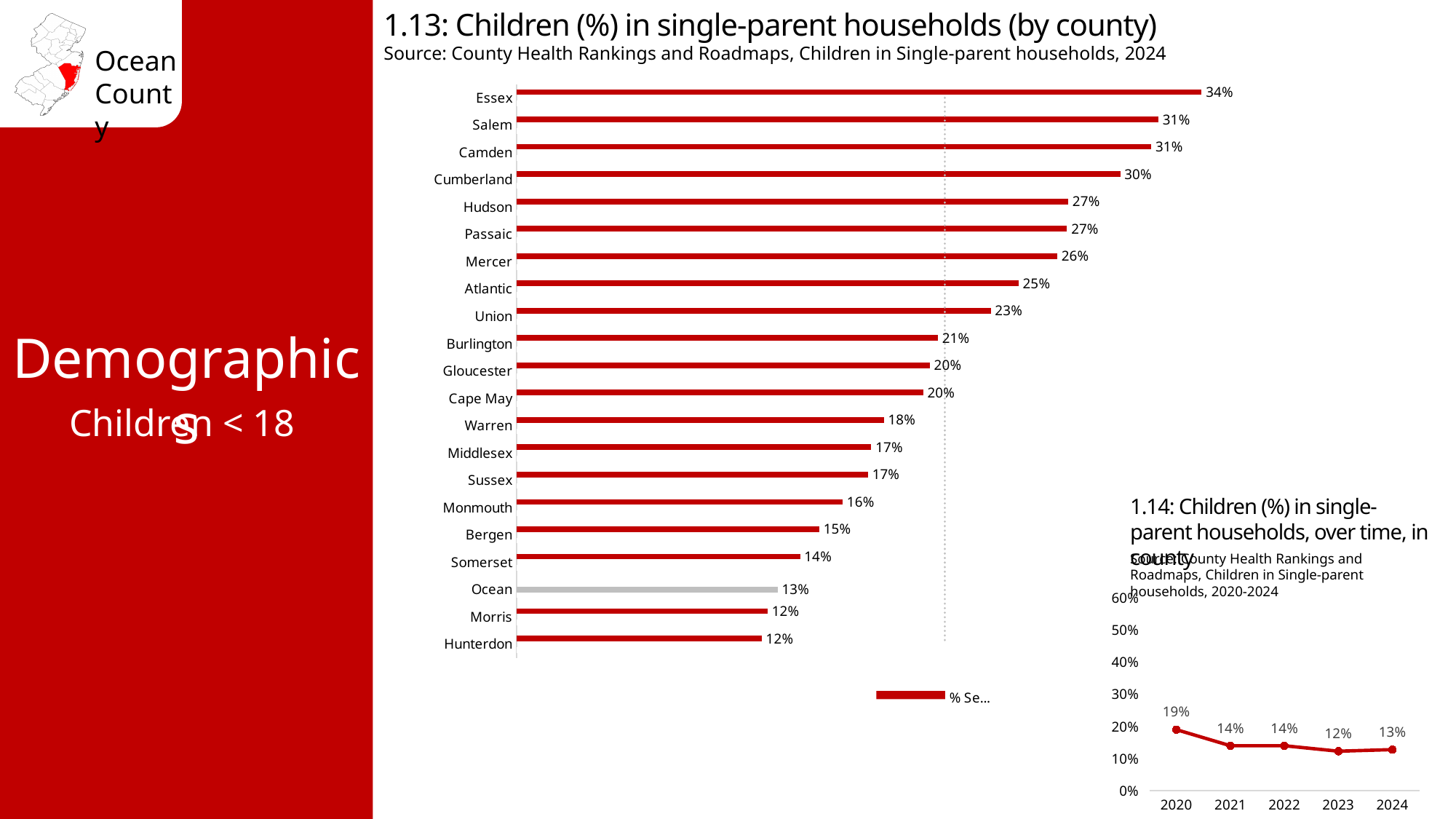
In chart 1.13 (Children (%) in single-parent households by county), what is the value for Ocean? 13% In chart 1.14 (over time), what is the difference between the values for 2020 and 2024? 6 percentage points In chart 1.13 (by county), what kind of chart is used? Bar chart In chart 1.13 (by county), what is the value for Hudson? 27% In chart 1.14 (over time), do the values generally rise or fall from 2020 to 2024? Fall In chart 1.14 (Children (%) in single-parent households over time), what is the value for 2020? 19% In chart 1.13 (by county), which county's bar is coloured grey instead of red? Ocean In chart 1.13 (by county), what is the difference between the values for Essex and Ocean? 21 percentage points In chart 1.13 (by county), which is larger, the value for Monmouth or the value for Bergen? Monmouth In chart 1.13 (by county), how many counties are shown? 21 In chart 1.13 (by county), which county has the highest percentage of children in single-parent households? Essex In chart 1.14 (over time), which year has the lowest value? 2023